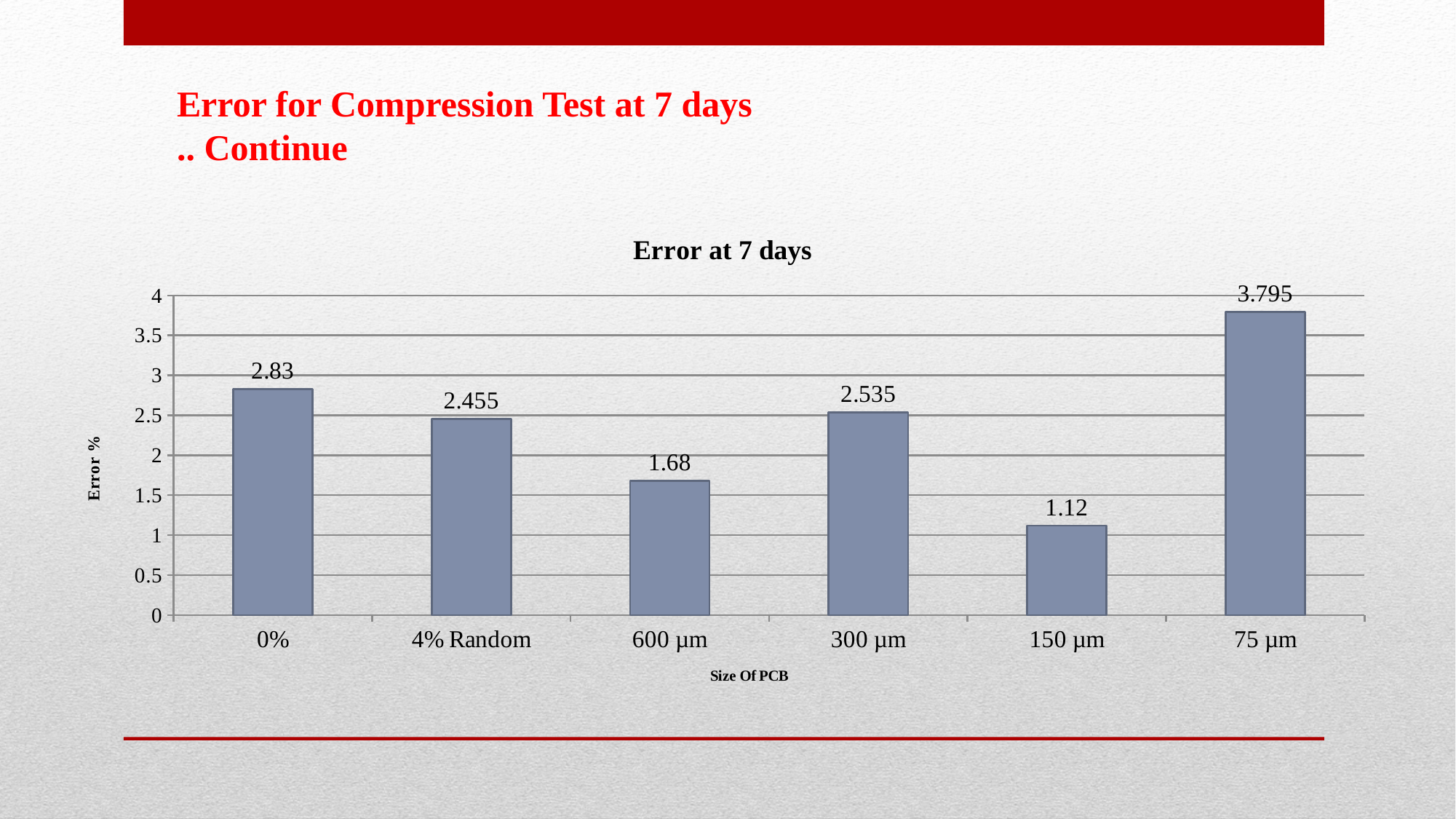
What kind of chart is shown? bar chart What is the difference between the error for 0% and the error for 600 µm? 1.15 What is the error value for 4% Random? 2.455 Which size of PCB has the lowest error? 150 µm What is the error value for 0%? 2.83 What is the error value for 150 µm? 1.12 Is the value for 600 µm greater or less than 2? less Which size of PCB has the highest error? 75 µm Which has a larger error, 300 µm or 4% Random? 300 µm How many sizes of PCB are shown on the x axis? 6 What is the title of the chart? Error at 7 days What is the difference between the error for 75 µm and the error for 150 µm? 2.675